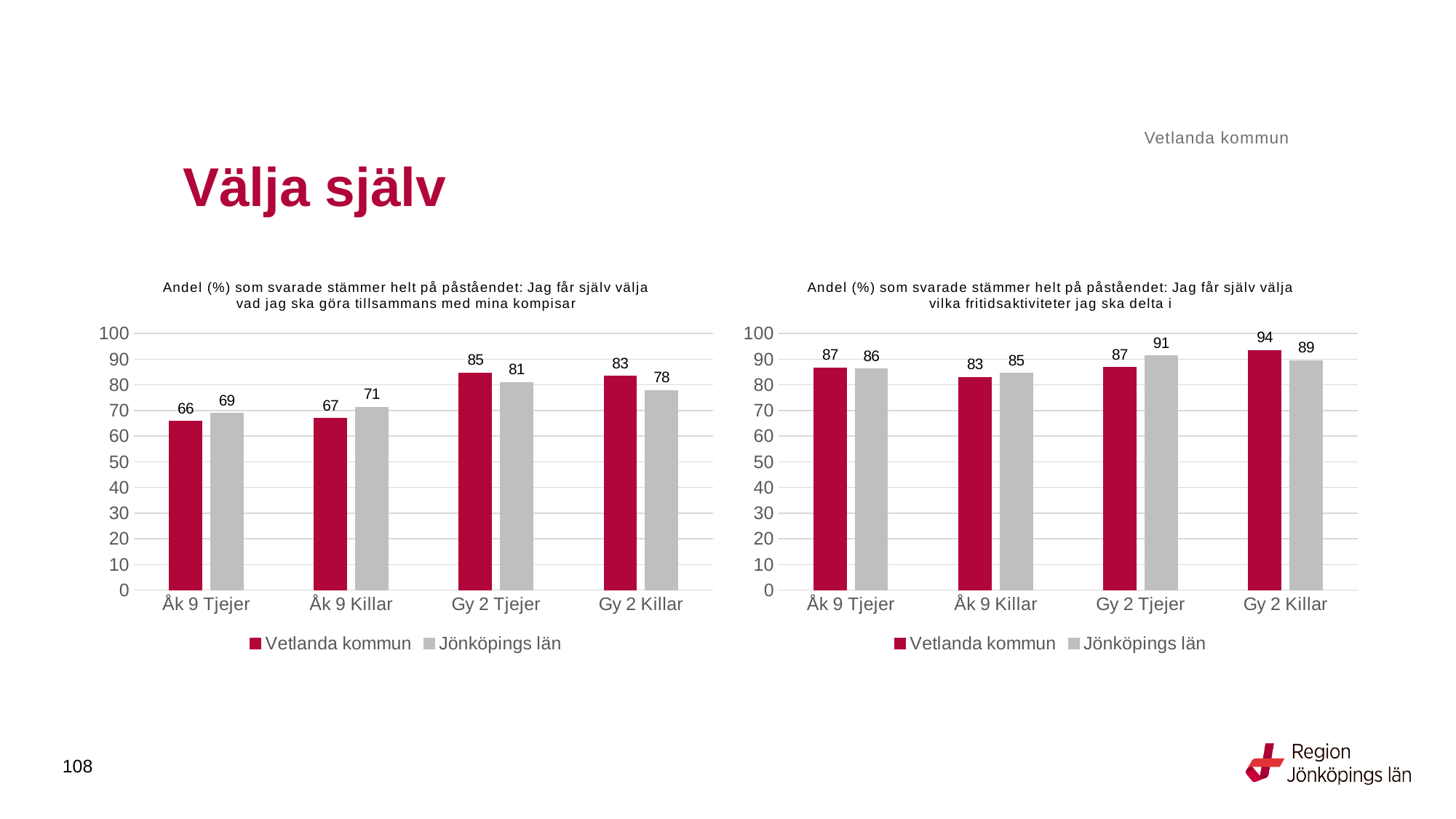
How many categories are shown on the x axis of the left chart? 4 In the left chart (about choosing what to do with friends), what is the difference between Jönköpings län and Vetlanda kommun for Åk 9 Killar? 4 In the left chart (about choosing what to do with friends), what is the value for Jönköpings län for Gy 2 Killar? 78 In the right chart (about choosing leisure activities), what is the difference between Vetlanda kommun and Jönköpings län for Gy 2 Killar? 5 In the left chart (about choosing what to do with friends), what is the value for Vetlanda kommun for Åk 9 Tjejer? 66 In the right chart (about choosing leisure activities), which is larger for Gy 2 Tjejer: Vetlanda kommun or Jönköpings län? Jönköpings län In the right chart (about choosing leisure activities), what is the value for Vetlanda kommun for Gy 2 Killar? 94 What kind of chart is the left chart? Bar chart In the right chart (about choosing leisure activities), what is the value for Jönköpings län for Åk 9 Killar? 85 How many series does the legend of the right chart list? 2 In the left chart (about choosing what to do with friends), which category has the highest value for Vetlanda kommun? Gy 2 Tjejer In the right chart (about choosing leisure activities), which category has the lowest value for Vetlanda kommun? Åk 9 Killar